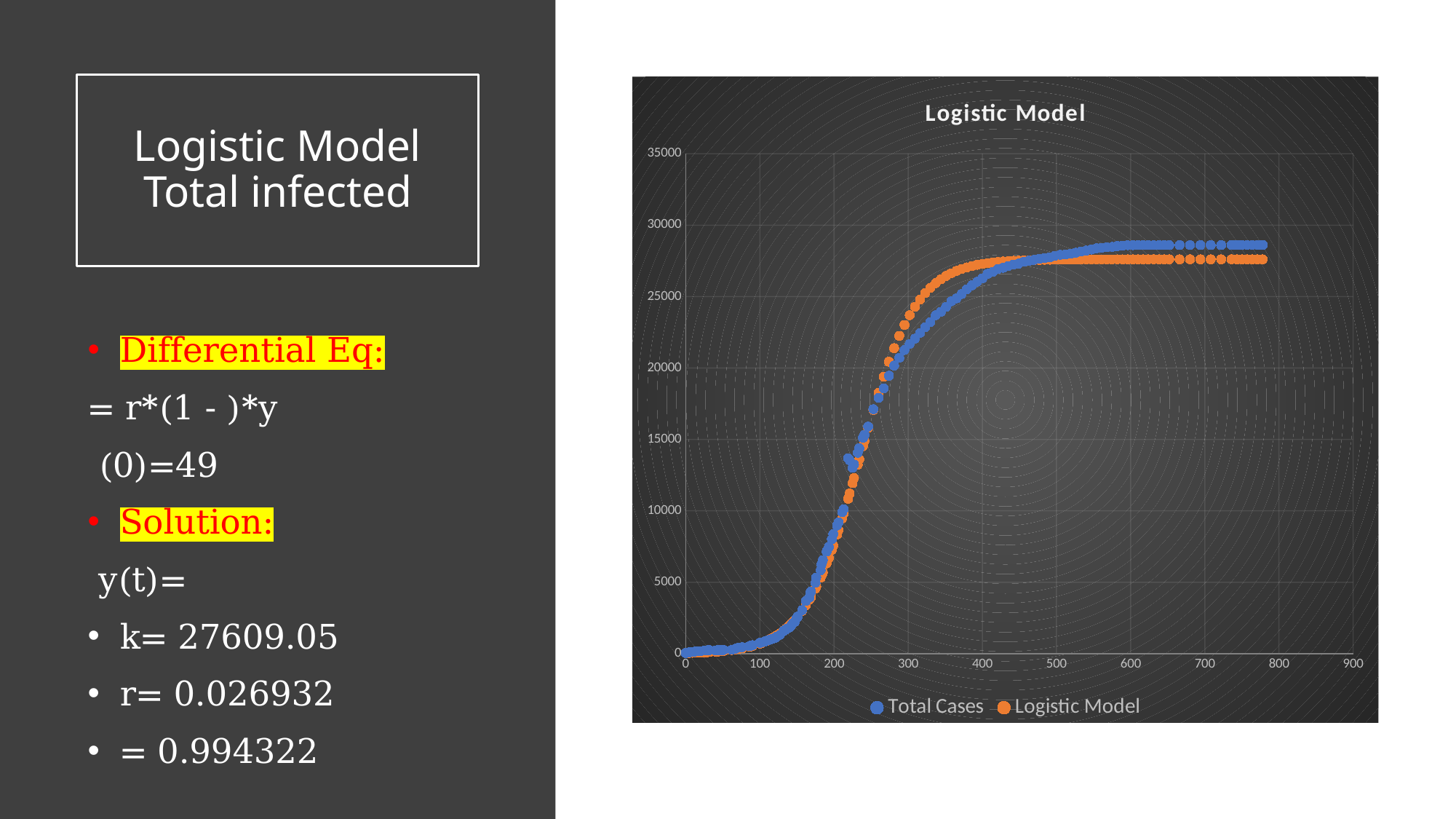
At x = 300, which series has the higher value, Total Cases or Logistic Model? Logistic Model What kind of chart is shown on the slide? Scatter chart What is the title of the chart? Logistic Model Is the Total Cases value at x = 200 greater or less than 5000? greater Is the Total Cases value at x = 400 greater or less than 25000? greater Which series is plotted in orange? Logistic Model At x = 700, which series has the higher value, Total Cases or Logistic Model? Total Cases Do the Total Cases values rise or fall as the x axis increases? Rise How many series does the chart's legend list? 2 Is the Logistic Model value at x = 100 greater or less than 5000? less